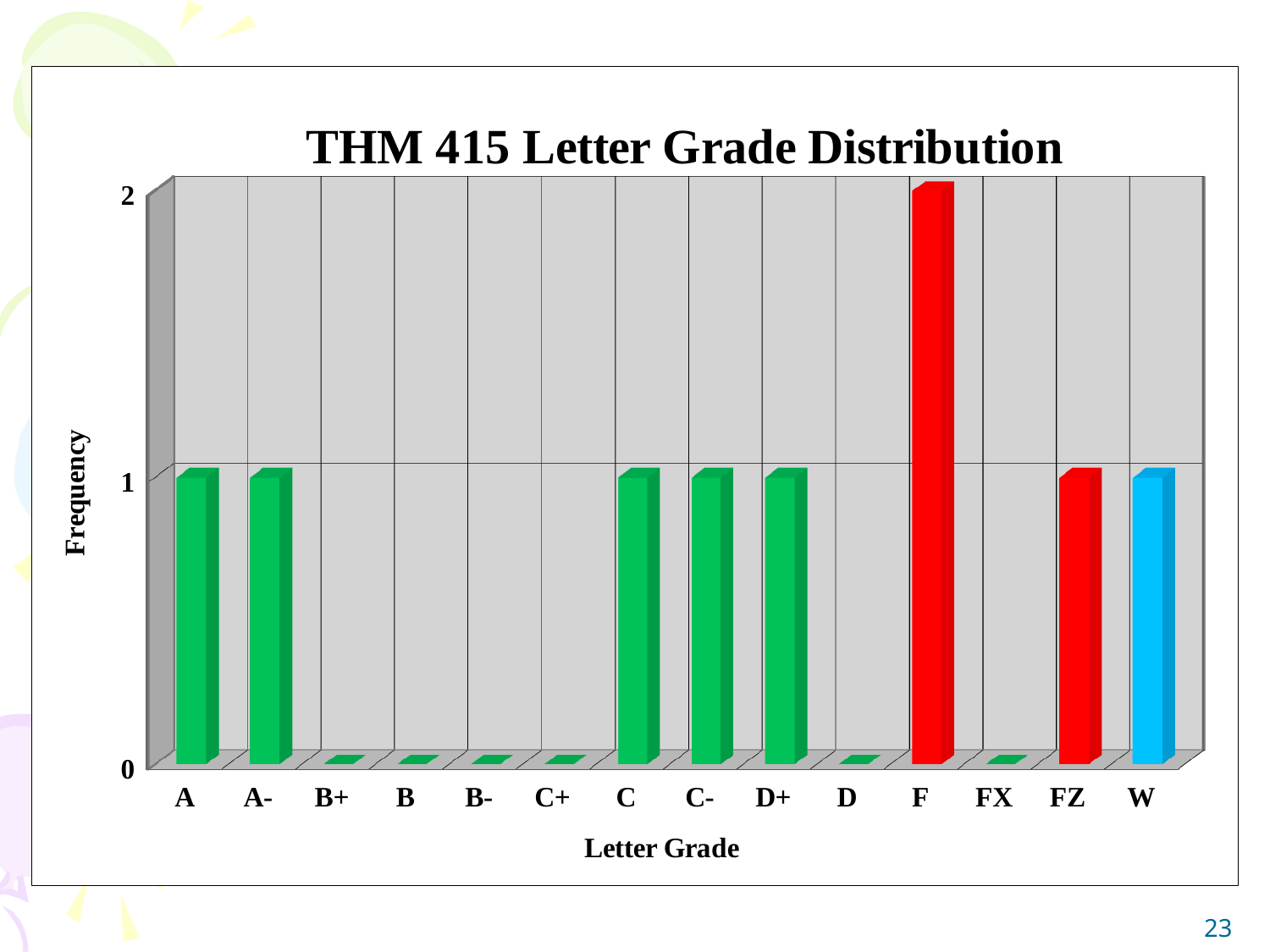
How many letter grade categories are shown on the x axis? 14 Which has a higher frequency, D or D+? D+ What is the title of the chart? THM 415 Letter Grade Distribution What is the frequency for letter grade F? 2 Which letter grade has the highest frequency? F What is the frequency for letter grade B+? 0 What is the frequency for letter grade W? 1 What kind of chart is shown on the slide? Bar chart What is the difference between the frequency for F and the frequency for FZ? 1 How many letter grades have a frequency of 0? 6 What is the label of the y axis? Frequency What is the frequency for letter grade A? 1